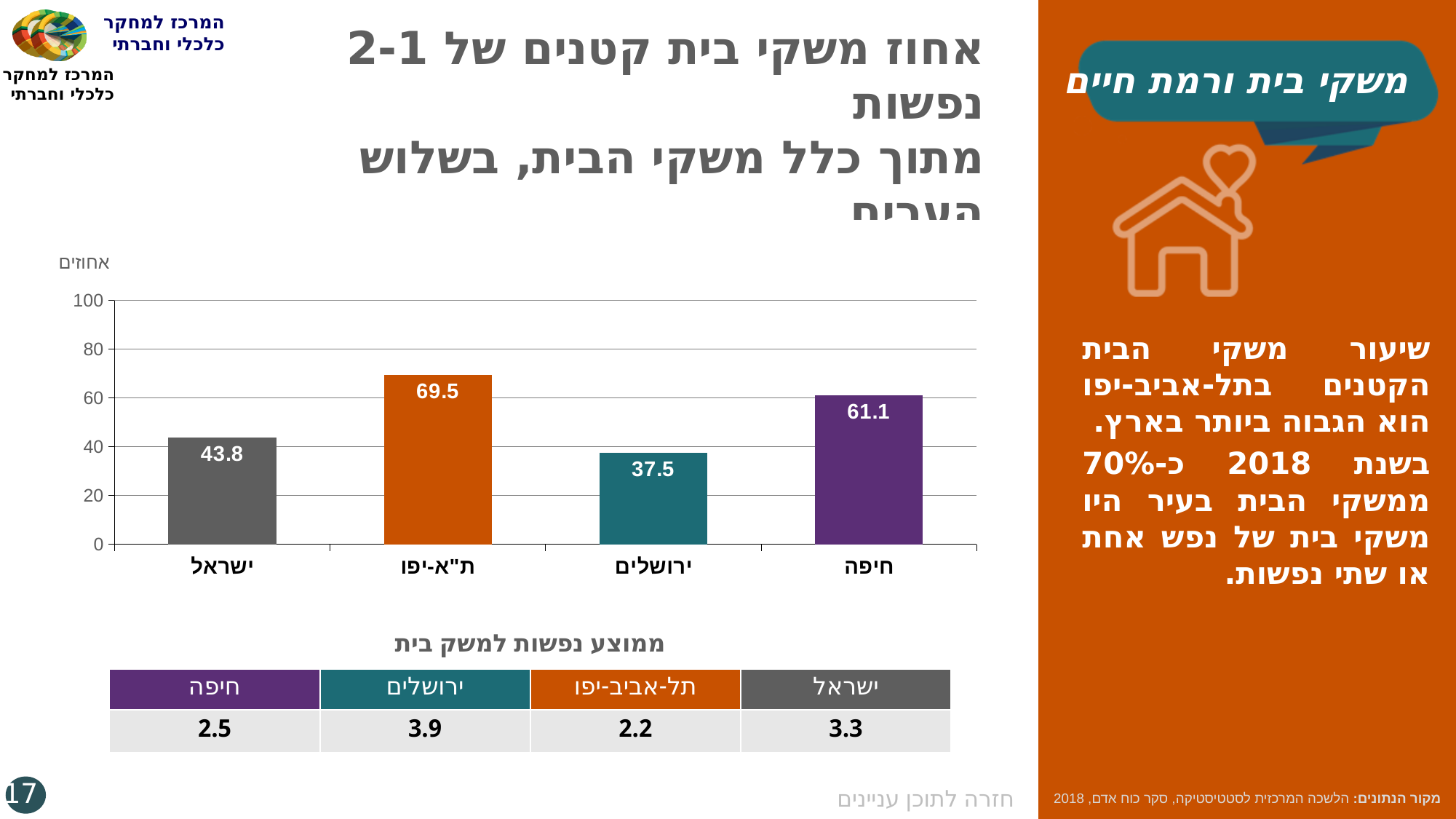
What is the value for ת"א-יפו in the bar chart? 69.5 What is the value for חיפה in the bar chart? 61.1 What type of chart is shown on the slide? bar chart How many categories are shown in the bar chart? 4 What is the value for ישראל in the bar chart? 43.8 Which category has the lowest value in the bar chart? ירושלים Which category has the highest value in the bar chart? ת"א-יפו What is the difference between the values for ת"א-יפו and ירושלים? 32 Which is larger, the value for חיפה or the value for ישראל? חיפה Is the value for ישראל greater or less than 60? less What is the label on the vertical axis of the bar chart? אחוזים What is the value for ירושלים in the bar chart? 37.5